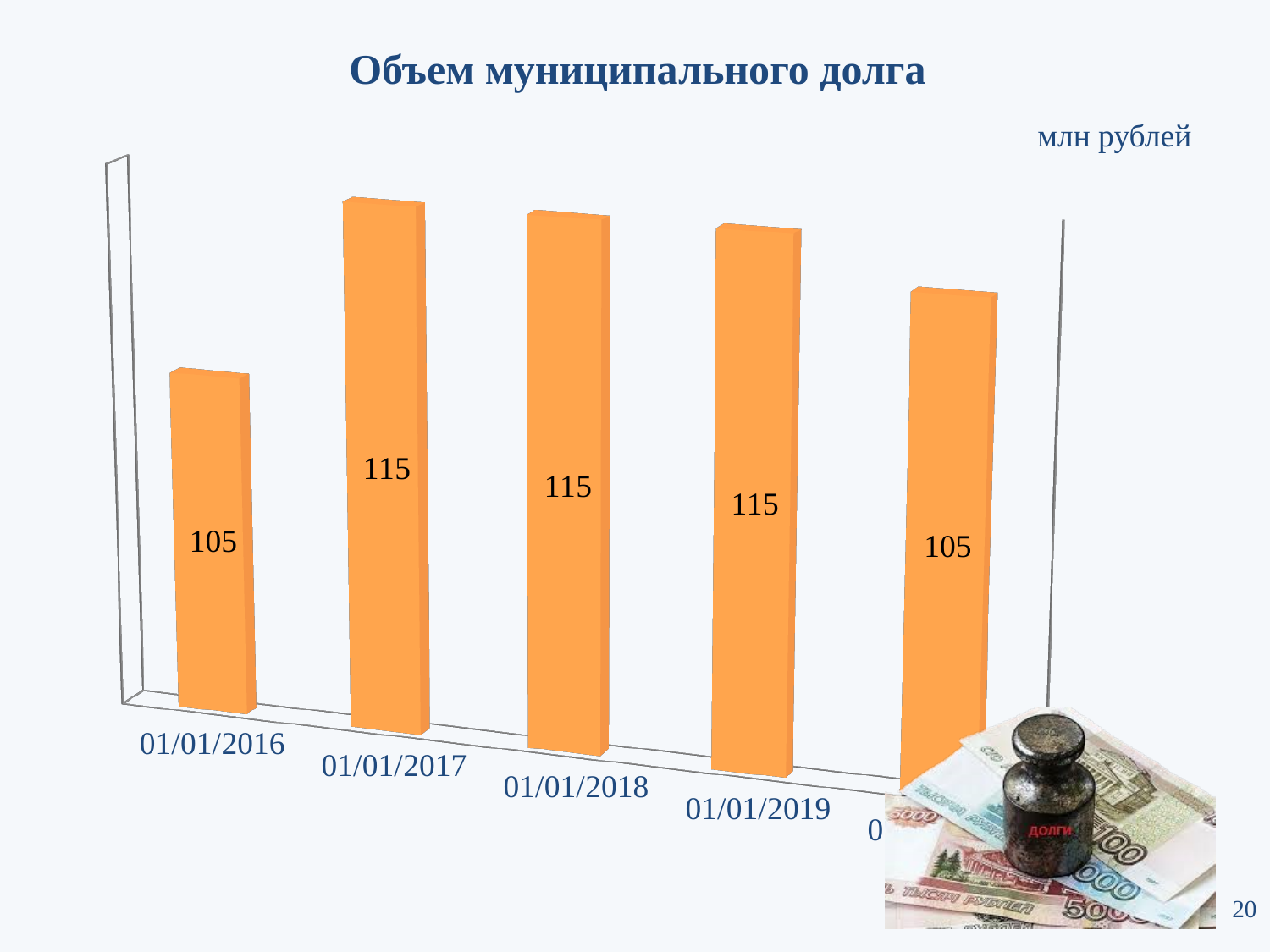
Which is larger, the value for 01/01/2016 or the value for 01/01/2017? 01/01/2017 What is the difference between the values for 01/01/2017 and 01/01/2016? 10 What is the value for 01/01/2017? 115 What is the value for 01/01/2018? 115 What is the highest value shown on the chart? 115 Does the value rise or fall from 01/01/2016 to 01/01/2017? rise What is the lowest value shown on the chart? 105 How many bars are plotted on the chart? 5 What is the value for 01/01/2019? 115 What kind of chart is shown on the slide? bar chart What is the title of the chart? Объем муниципального долга What is the value for 01/01/2016? 105